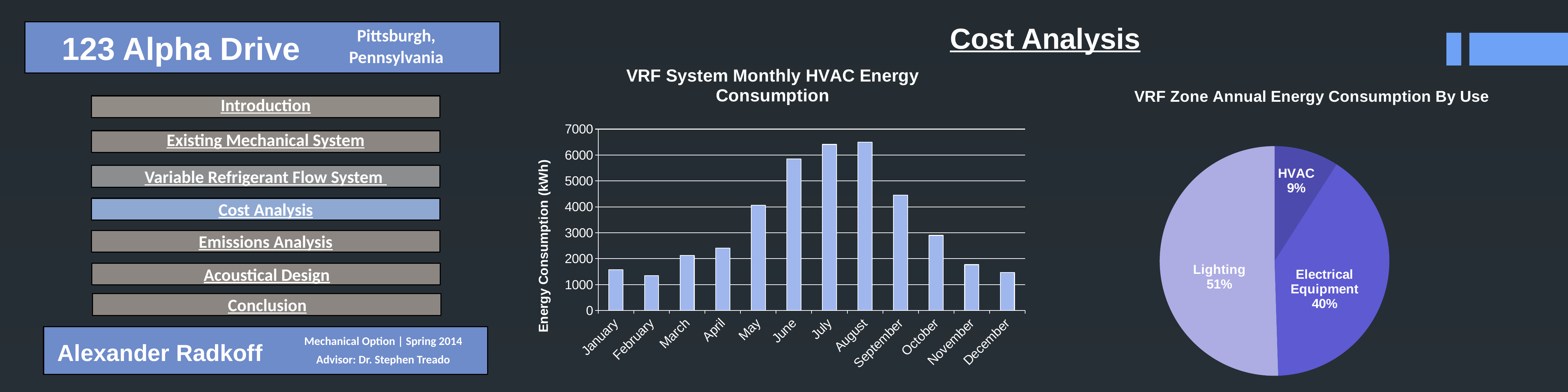
In the VRF System Monthly HVAC Energy Consumption chart, how many months are plotted? 12 In the VRF Zone Annual Energy Consumption By Use pie chart, which use has the largest share? Lighting In the VRF Zone Annual Energy Consumption By Use pie chart, how many percentage points larger is Lighting's share than Electrical Equipment's? 11 In the VRF Zone Annual Energy Consumption By Use pie chart, what share does HVAC have? 9% In the VRF Zone Annual Energy Consumption By Use pie chart, which use has the smallest share? HVAC In the VRF System Monthly HVAC Energy Consumption chart, is the value for August greater or less than 6000? greater In the VRF Zone Annual Energy Consumption By Use pie chart, how many slices are there? 3 In the VRF System Monthly HVAC Energy Consumption chart, is the value for February greater or less than 2000? less What kind of chart is the VRF System Monthly HVAC Energy Consumption chart? bar chart In the VRF System Monthly HVAC Energy Consumption chart, which is larger, the value for June or the value for October? June In the VRF Zone Annual Energy Consumption By Use pie chart, what share does Lighting have? 51% In the VRF Zone Annual Energy Consumption By Use pie chart, what share does Electrical Equipment have? 40%